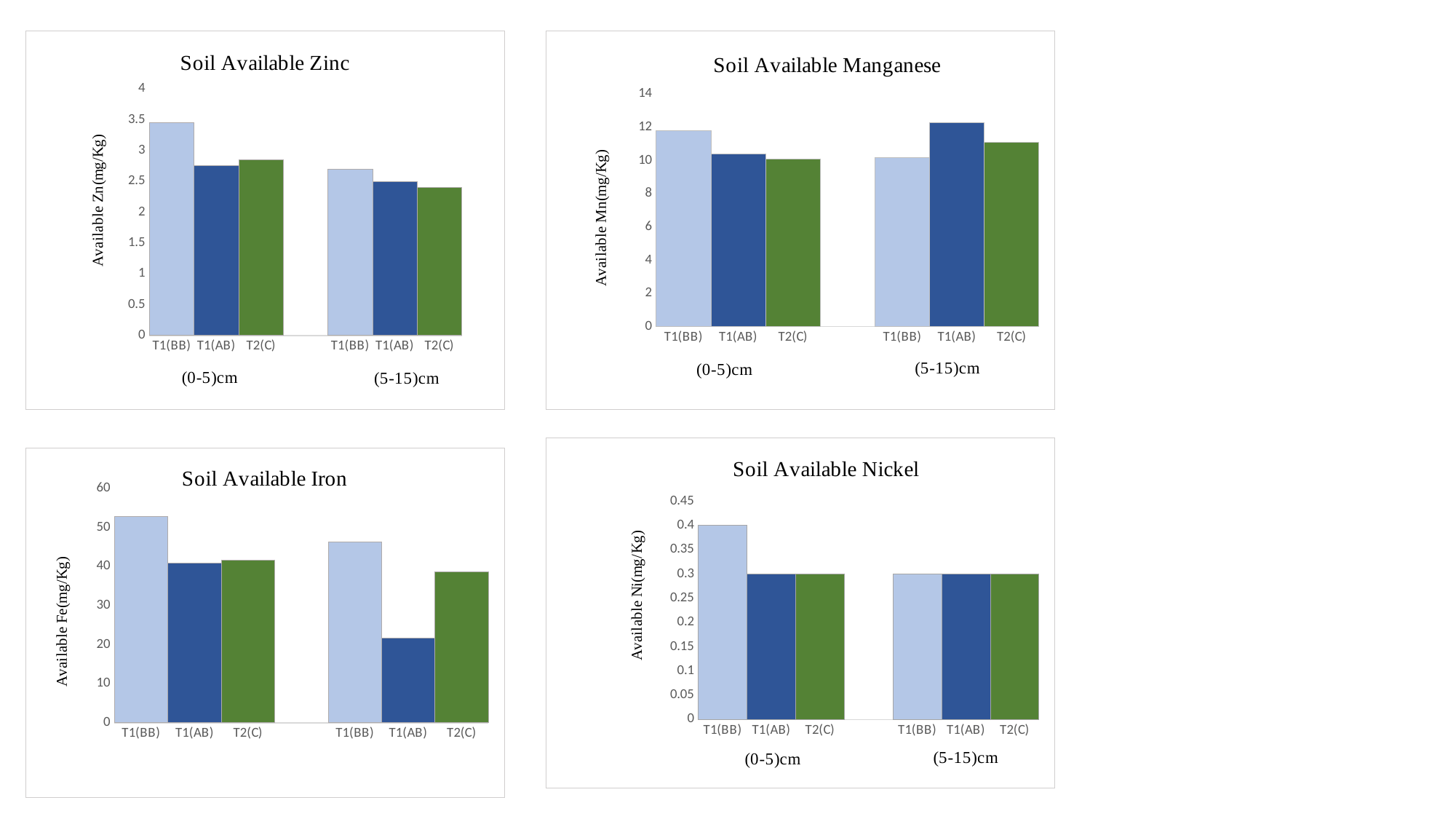
In the 'Soil Available Zinc' chart, is the value for T1(BB) at (0-5)cm greater or less than 3? greater How many charts are shown on the slide? 4 What is the y-axis title of the 'Soil Available Iron' chart? Available Fe(mg/Kg) In the 'Soil Available Iron' chart, which bar is the lowest? T1(AB) at (5-15)cm In the 'Soil Available Manganese' chart, which is larger at (5-15)cm: T1(BB) or T1(AB)? T1(AB) In the 'Soil Available Zinc' chart, is the value for T2(C) at (5-15)cm greater or less than 2.5? less What kind of chart is 'Soil Available Zinc'? bar chart In the 'Soil Available Nickel' chart, which bar is the highest? T1(BB) at (0-5)cm In the 'Soil Available Iron' chart, which bar is the highest? T1(BB) at (0-5)cm In the 'Soil Available Manganese' chart, is the value for T1(BB) at (0-5)cm greater or less than 10? greater In the 'Soil Available Zinc' chart, which bar is the highest? T1(BB) at (0-5)cm